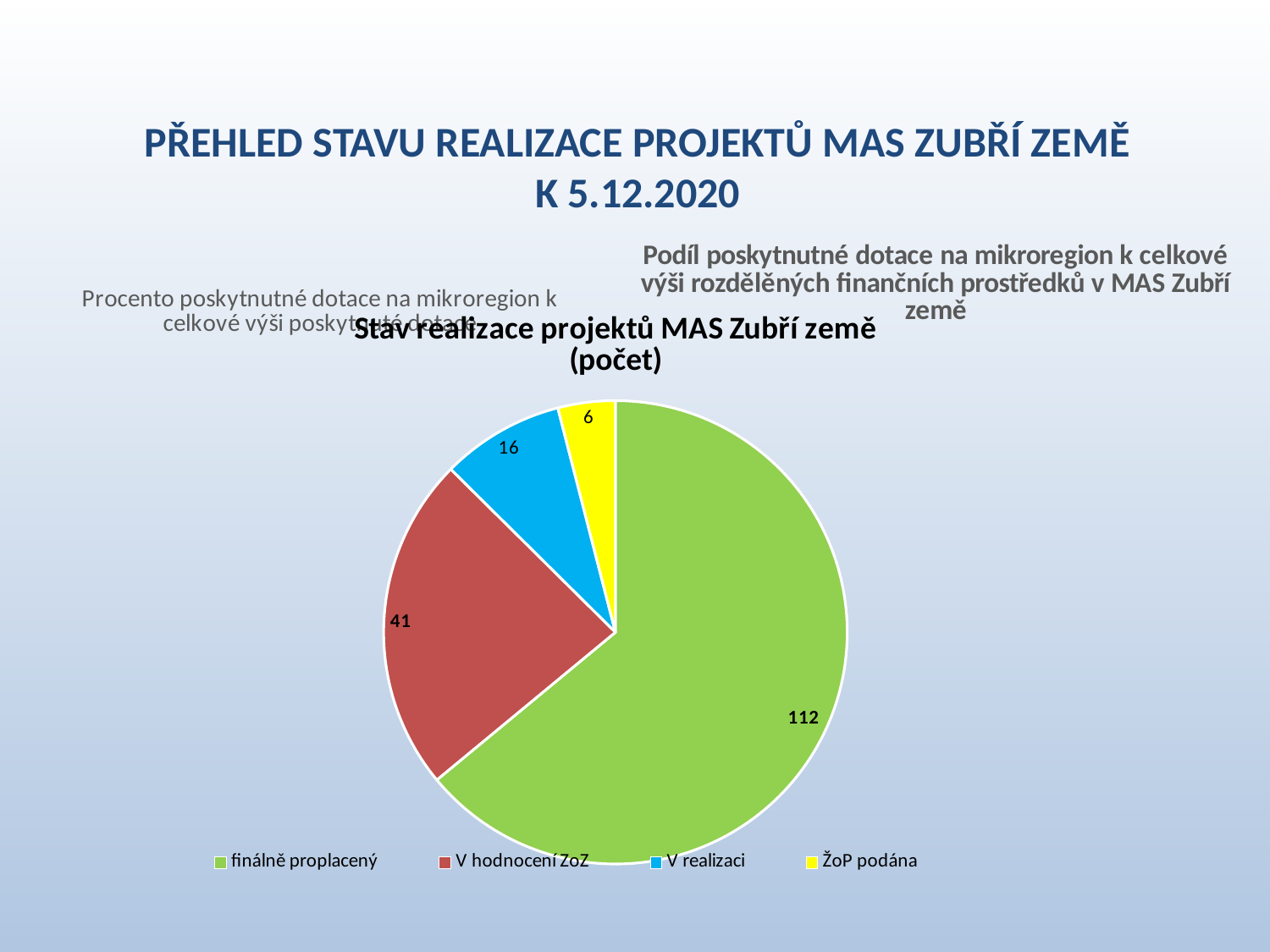
What is the value for 'V hodnocení ZoZ'? 41 What is the total of all slices in the pie chart? 175 How many slices does the pie chart have? 4 What type of chart is shown on the slide? pie chart What is the value for 'ŽoP podána'? 6 What is the difference between the values for 'finálně proplacený' and 'V hodnocení ZoZ'? 71 Which category has the largest slice of the pie? finálně proplacený What is the title of the pie chart? Stav realizace projektů MAS Zubří země (počet) What is the value for 'finálně proplacený'? 112 Which is larger, the value for 'V realizaci' or the value for 'ŽoP podána'? V realizaci What is the value for 'V realizaci'? 16 Which category has the smallest slice of the pie? ŽoP podána